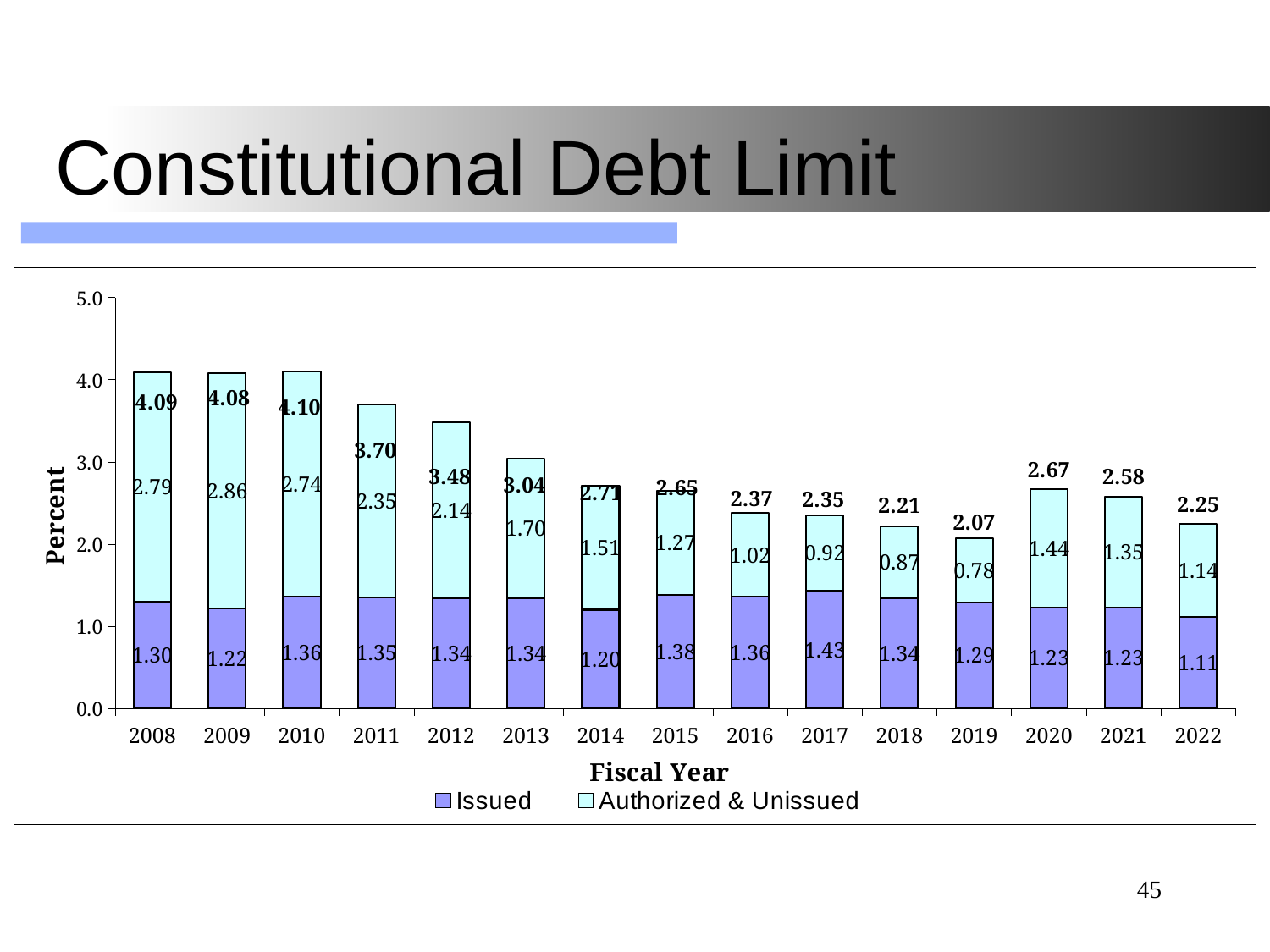
What is the total of the stacked bar for fiscal year 2011? 3.70 What is the Issued value for fiscal year 2017? 1.43 Which fiscal year has the highest Issued value? 2017 What is the Authorized & Unissued value for fiscal year 2012? 2.14 What is the difference between the Issued value for 2017 and the Issued value for 2022? 0.32 Is the Issued value for 2015 larger or smaller than the Issued value for 2014? Larger How many fiscal years are shown on the x axis? 15 Which fiscal year has the lowest stacked bar total? 2019 How many series does the legend list? 2 Which fiscal year has the lowest Authorized & Unissued value? 2019 What kind of chart is shown on the slide? Stacked bar chart Do the stacked bar totals rise or fall from 2008 to 2019? Fall